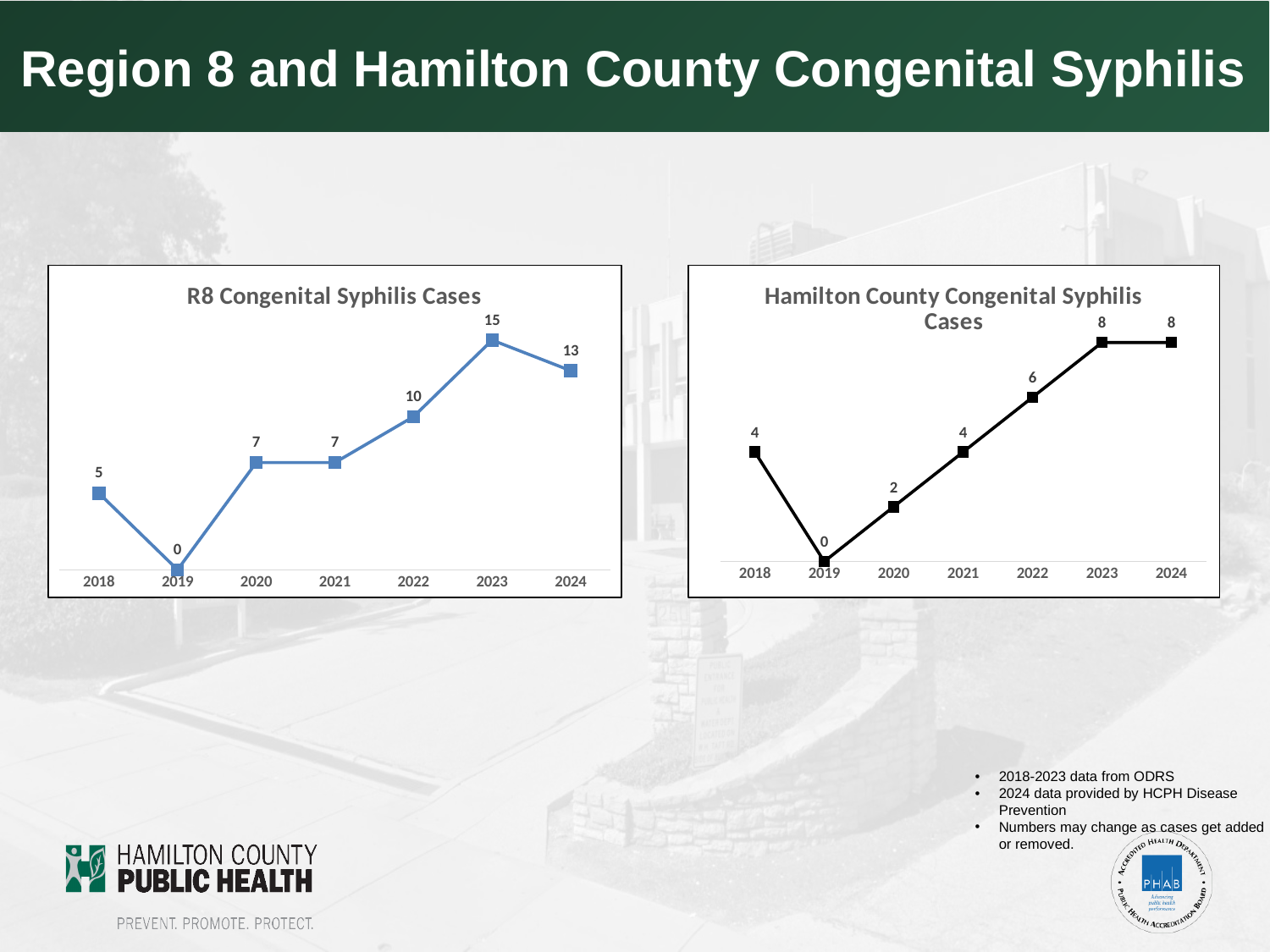
In the R8 Congenital Syphilis Cases chart, which year has more cases, 2020 or 2022? 2022 In the Hamilton County Congenital Syphilis Cases chart, how many cases were there in 2022? 6 In the R8 Congenital Syphilis Cases chart, which year has the highest number of cases? 2023 In the R8 Congenital Syphilis Cases chart, how many cases were there in 2023? 15 How many years are plotted in the R8 Congenital Syphilis Cases chart? 7 In the R8 Congenital Syphilis Cases chart, what is the difference between the 2023 and 2024 values? 2 In the Hamilton County Congenital Syphilis Cases chart, which year has more cases, 2020 or 2023? 2023 In the Hamilton County Congenital Syphilis Cases chart, which year has the lowest number of cases? 2019 What is the title of the chart on the left side of the slide? R8 Congenital Syphilis Cases What kind of chart is the Hamilton County Congenital Syphilis Cases chart? Line chart In the Hamilton County Congenital Syphilis Cases chart, what is the difference between the 2018 and 2021 values? 0 In the Hamilton County Congenital Syphilis Cases chart, do the values rise or fall from 2019 to 2023? Rise